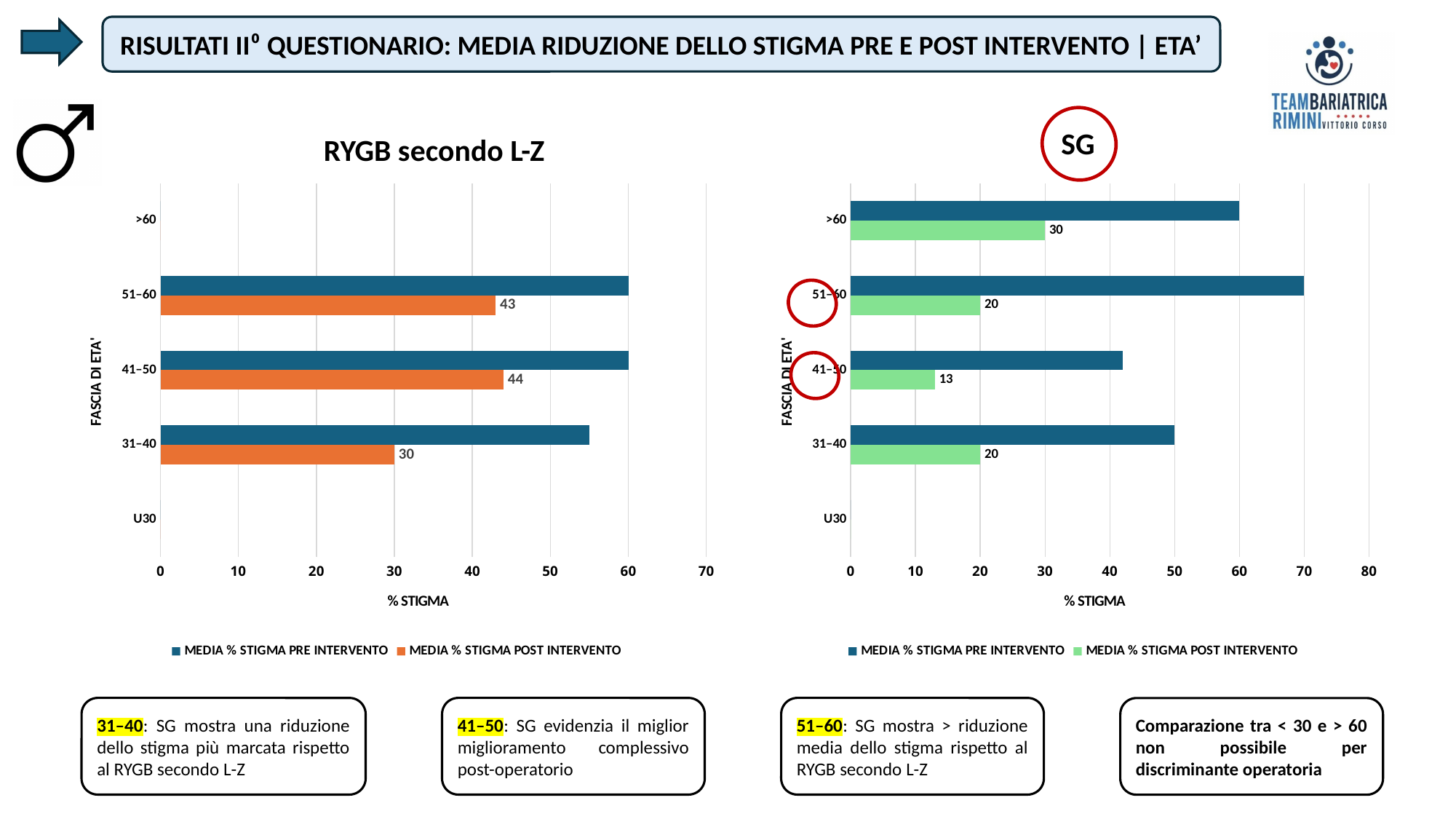
In the SG chart, which is larger for the 31–40 age group: the PRE INTERVENTO value or the POST INTERVENTO value? PRE INTERVENTO In the SG chart, what is the difference between the MEDIA % STIGMA POST INTERVENTO values for >60 and 41–50? 17 In the RYGB secondo L-Z chart, what is the MEDIA % STIGMA POST INTERVENTO value for the 41–50 age group? 44 In the SG chart, is the MEDIA % STIGMA PRE INTERVENTO value for the 51–60 age group greater or less than 60? greater In the RYGB secondo L-Z chart, what is the MEDIA % STIGMA POST INTERVENTO value for the 31–40 age group? 30 In the RYGB secondo L-Z chart, what is the difference between the MEDIA % STIGMA POST INTERVENTO values for 41–50 and 31–40? 14 In the SG chart, which age group has the lowest MEDIA % STIGMA POST INTERVENTO value? 41–50 In the SG chart, what is the MEDIA % STIGMA POST INTERVENTO value for the 41–50 age group? 13 In the RYGB secondo L-Z chart, is the MEDIA % STIGMA PRE INTERVENTO value for the 31–40 age group greater or less than 50? greater In the SG chart, what is the MEDIA % STIGMA POST INTERVENTO value for the >60 age group? 30 What type of chart is the RYGB secondo L-Z chart? Bar chart How many series does the legend of the SG chart list? 2